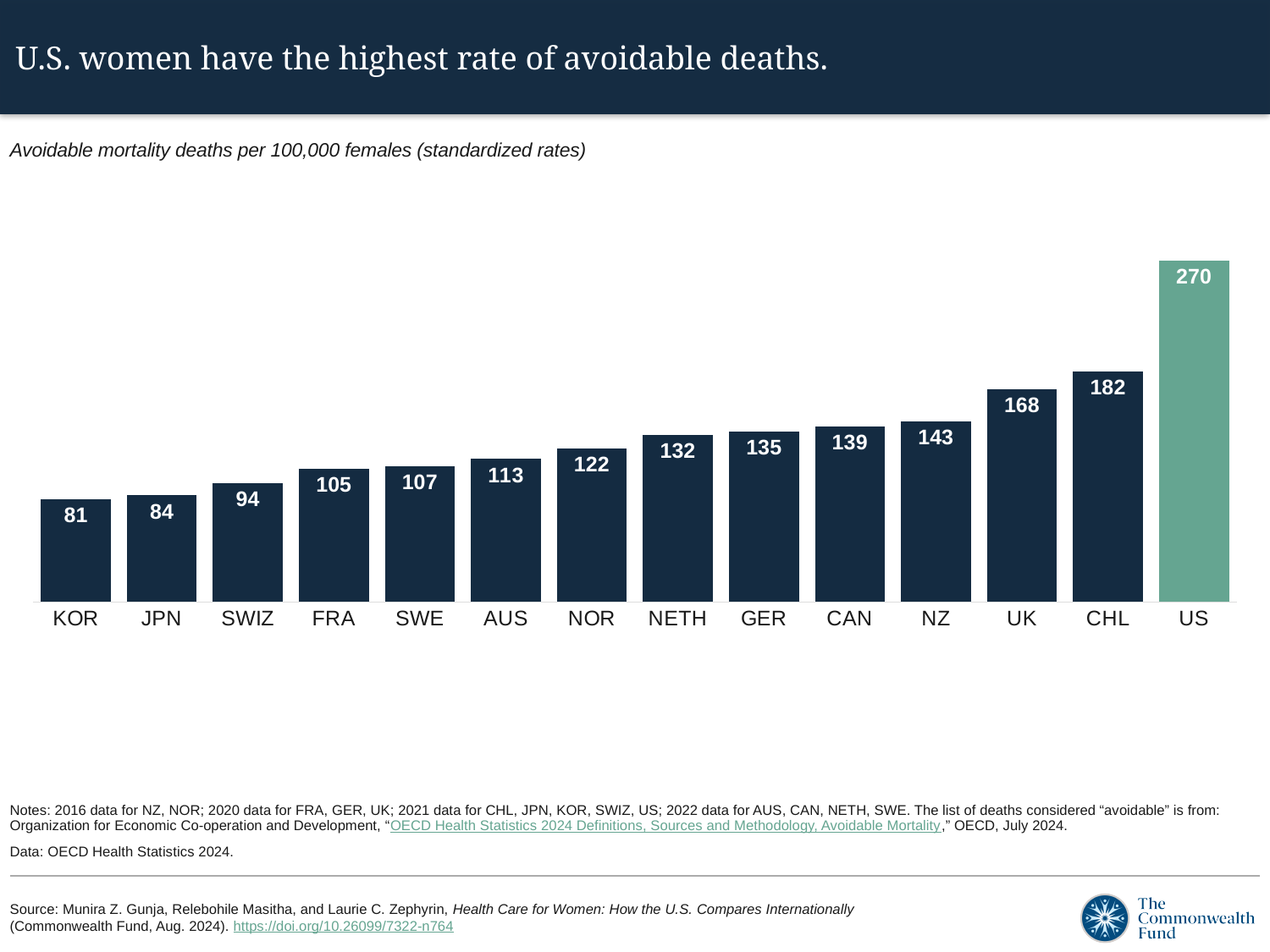
What is the difference between the values for the US and CHL? 88 Do the values rise or fall moving from left to right along the x axis? Rise Which bar is shown in a different colour from the others? US How many countries are shown in the chart? 14 What kind of chart is shown on the slide? Bar chart What is the avoidable mortality rate per 100,000 females for the US? 270 Which has a higher value, NOR or AUS? NOR Which country has the highest avoidable mortality rate? US Which country has the lowest avoidable mortality rate? KOR What is the value shown for GER? 135 What is the value shown for SWIZ? 94 What is the difference between the values for UK and NZ? 25